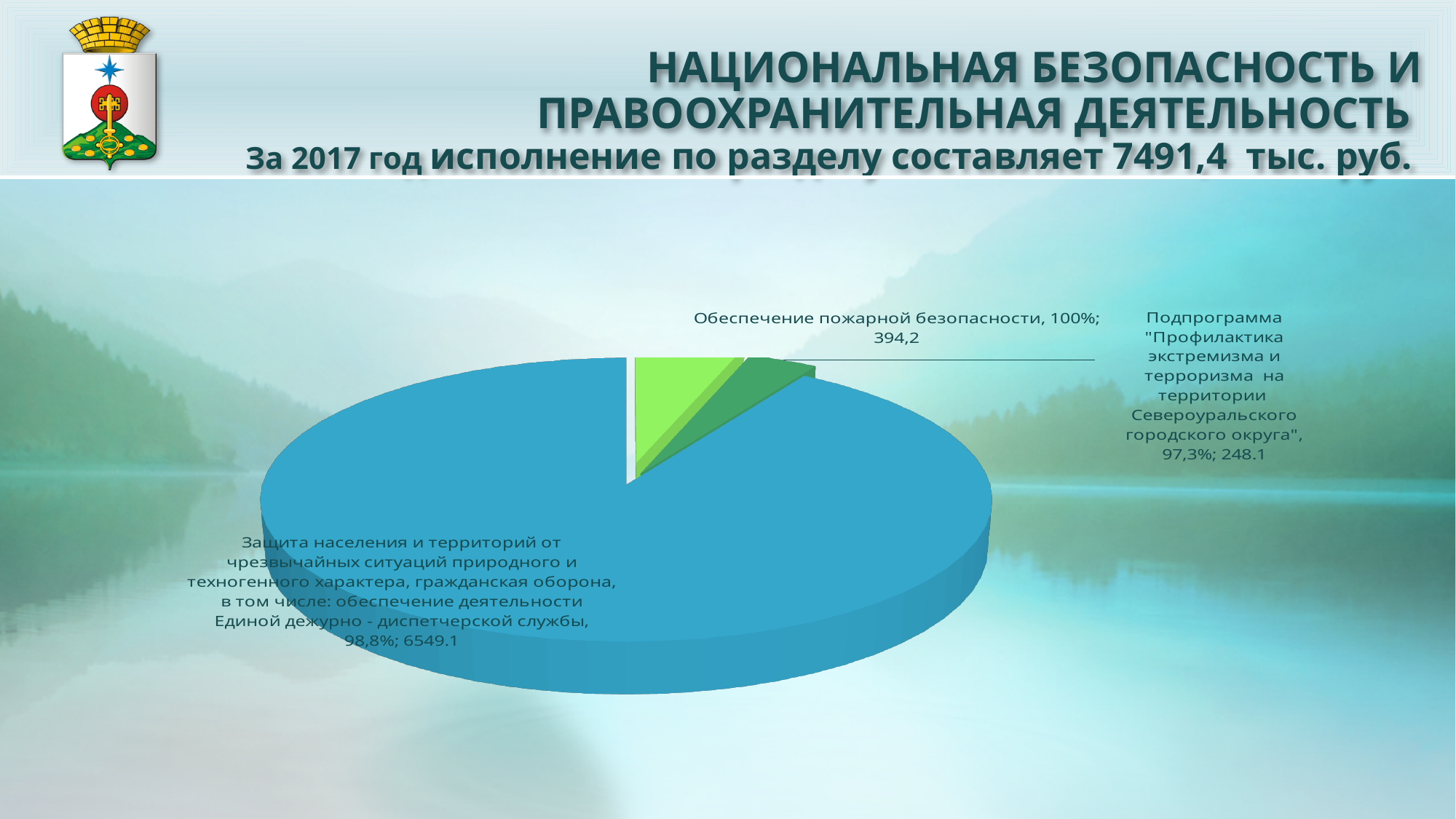
What type of chart is shown on the slide? pie chart What execution percentage is shown for the subprogram on prevention of extremism and terrorism? 97,3% What value is shown for "Обеспечение пожарной безопасности"? 394,2 What value is shown for "Защита населения и территорий от чрезвычайных ситуаций природного и техногенного характера, гражданская оборона"? 6549.1 What is the difference between the value for "Обеспечение пожарной безопасности" and the value for the subprogram on prevention of extremism and terrorism? 146.1 What execution percentage is shown for "Обеспечение пожарной безопасности"? 100% Which slice of the pie chart has the smallest value? Подпрограмма "Профилактика экстремизма и терроризма на территории Североуральского городского округа" How many slices does the pie chart have? 3 According to the slide title, what is the total execution for the section in 2017? 7491,4 тыс. руб. Which slice of the pie chart has the largest value? Защита населения и территорий от чрезвычайных ситуаций природного и техногенного характера, гражданская оборона What value is shown for the subprogram "Профилактика экстремизма и терроризма на территории Североуральского городского округа"? 248.1 Which is larger: the value for "Обеспечение пожарной безопасности" or the value for the subprogram on prevention of extremism and terrorism? Обеспечение пожарной безопасности